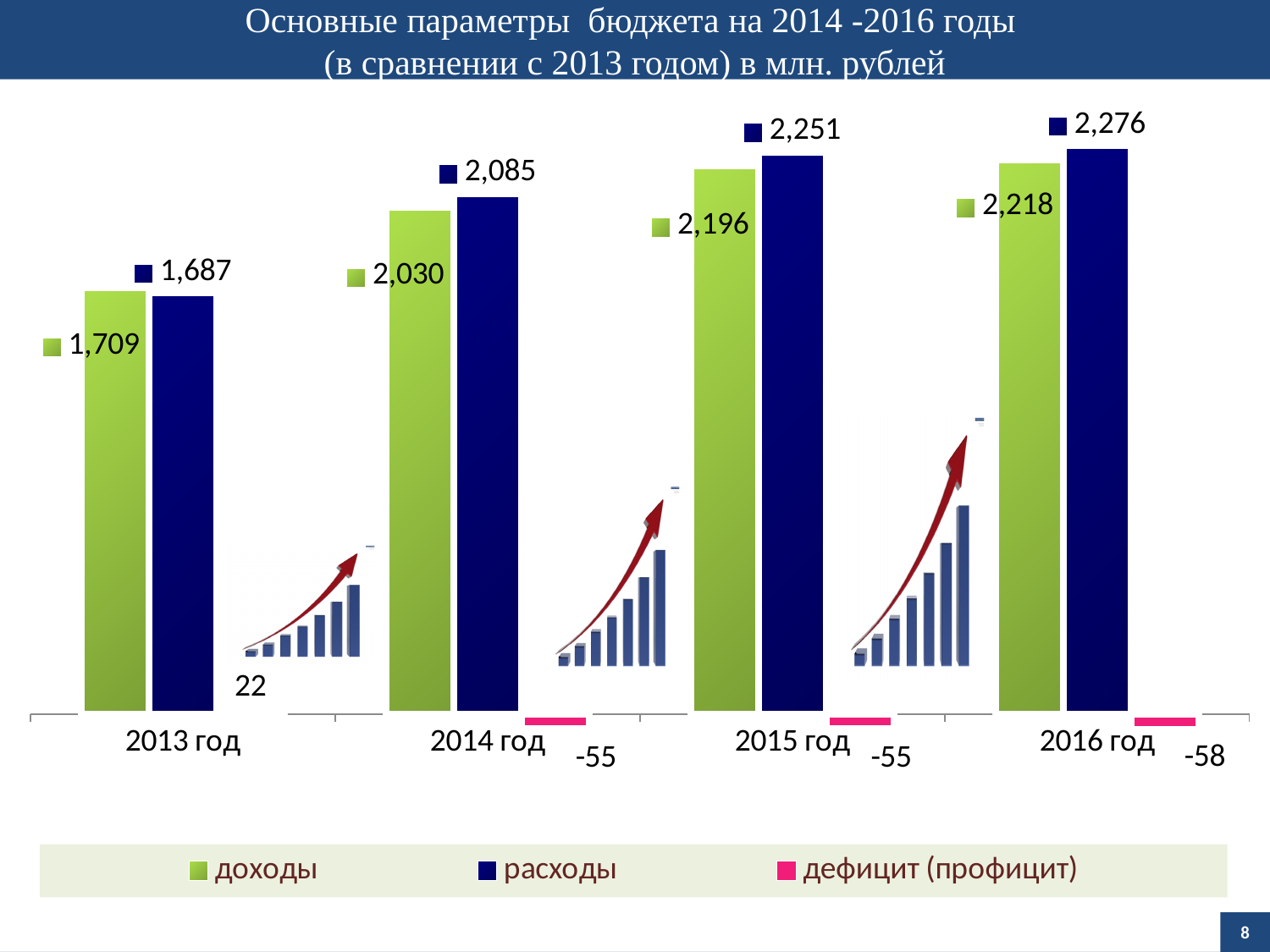
Do the values of расходы rise or fall from 2013 год to 2016 год? rise What is the value of расходы for 2014 год? 2,085 What is the value of дефицит (профицит) for 2014 год? -55 Which year has the lowest value of расходы? 2013 год How many series does the legend list? 3 Which is larger for 2013 год: доходы or расходы? доходы What is the difference between расходы and доходы for 2015 год? 55 What kind of chart is shown on the slide? bar chart What is the value of доходы for 2013 год? 1,709 What is the value of расходы for 2016 год? 2,276 How many years are shown on the x axis? 4 Which year has the highest value of доходы? 2016 год